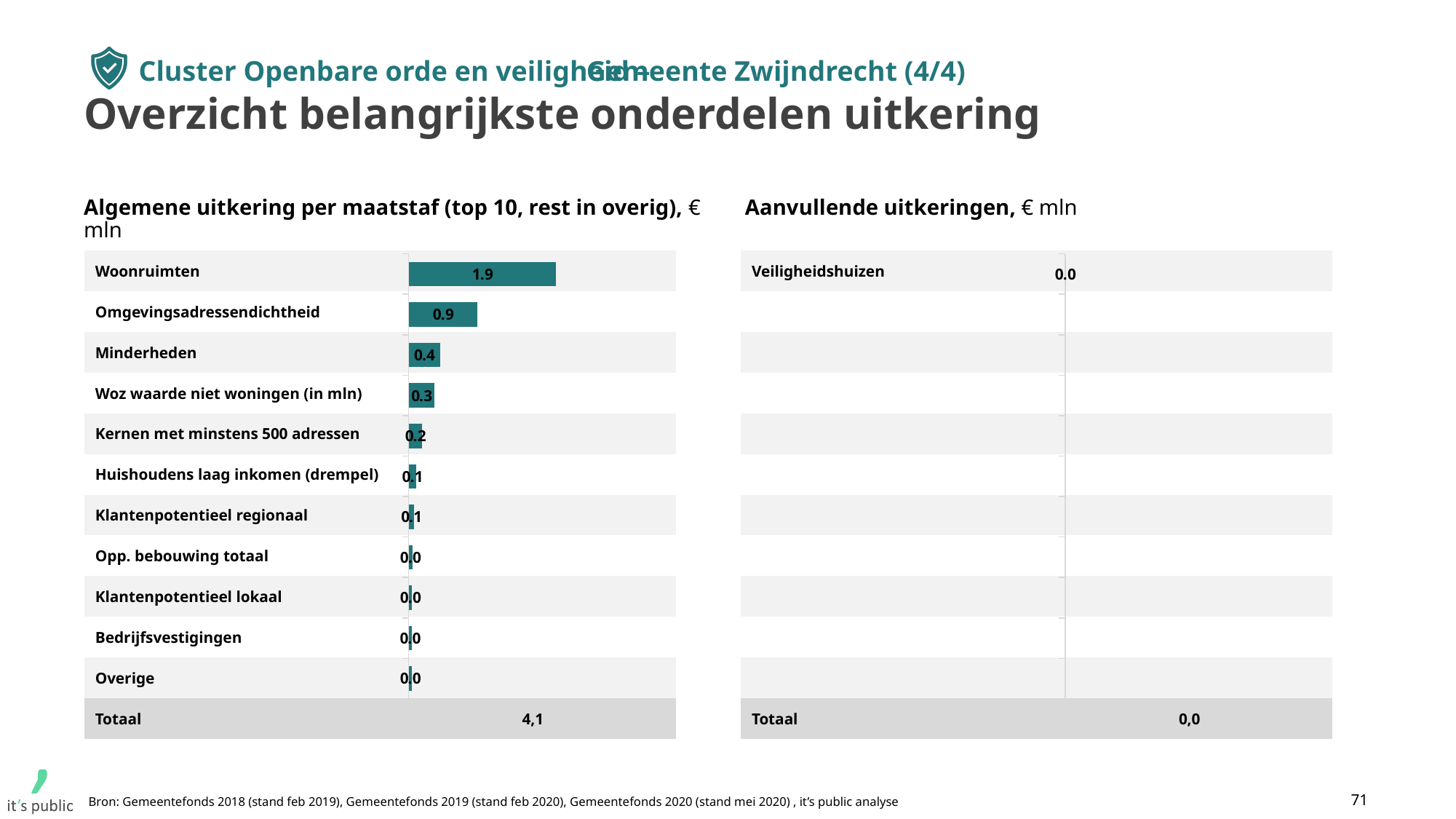
In the 'Algemene uitkering per maatstaf' chart, what is the value for Omgevingsadressendichtheid? 0.9 In the 'Algemene uitkering per maatstaf' chart, which is larger: Minderheden or Woz waarde niet woningen (in mln)? Minderheden In the 'Algemene uitkering per maatstaf' chart, what is the difference between Woonruimten and Omgevingsadressendichtheid? 1.0 In the 'Algemene uitkering per maatstaf' chart, what is the value for Minderheden? 0.4 What is the Totaal shown for the 'Algemene uitkering per maatstaf' chart? 4,1 In the 'Aanvullende uitkeringen' chart, what is the value for Veiligheidshuizen? 0.0 How many categories are listed in the 'Algemene uitkering per maatstaf' chart (excluding the Totaal row)? 11 What kind of chart is the 'Algemene uitkering per maatstaf' chart? Bar chart In the 'Algemene uitkering per maatstaf' chart, which category has the highest value? Woonruimten What is the Totaal shown for the 'Aanvullende uitkeringen' chart? 0,0 In the 'Algemene uitkering per maatstaf' chart, what is the value for Woonruimten? 1.9 In the 'Algemene uitkering per maatstaf' chart, what is the value for Kernen met minstens 500 adressen? 0.2